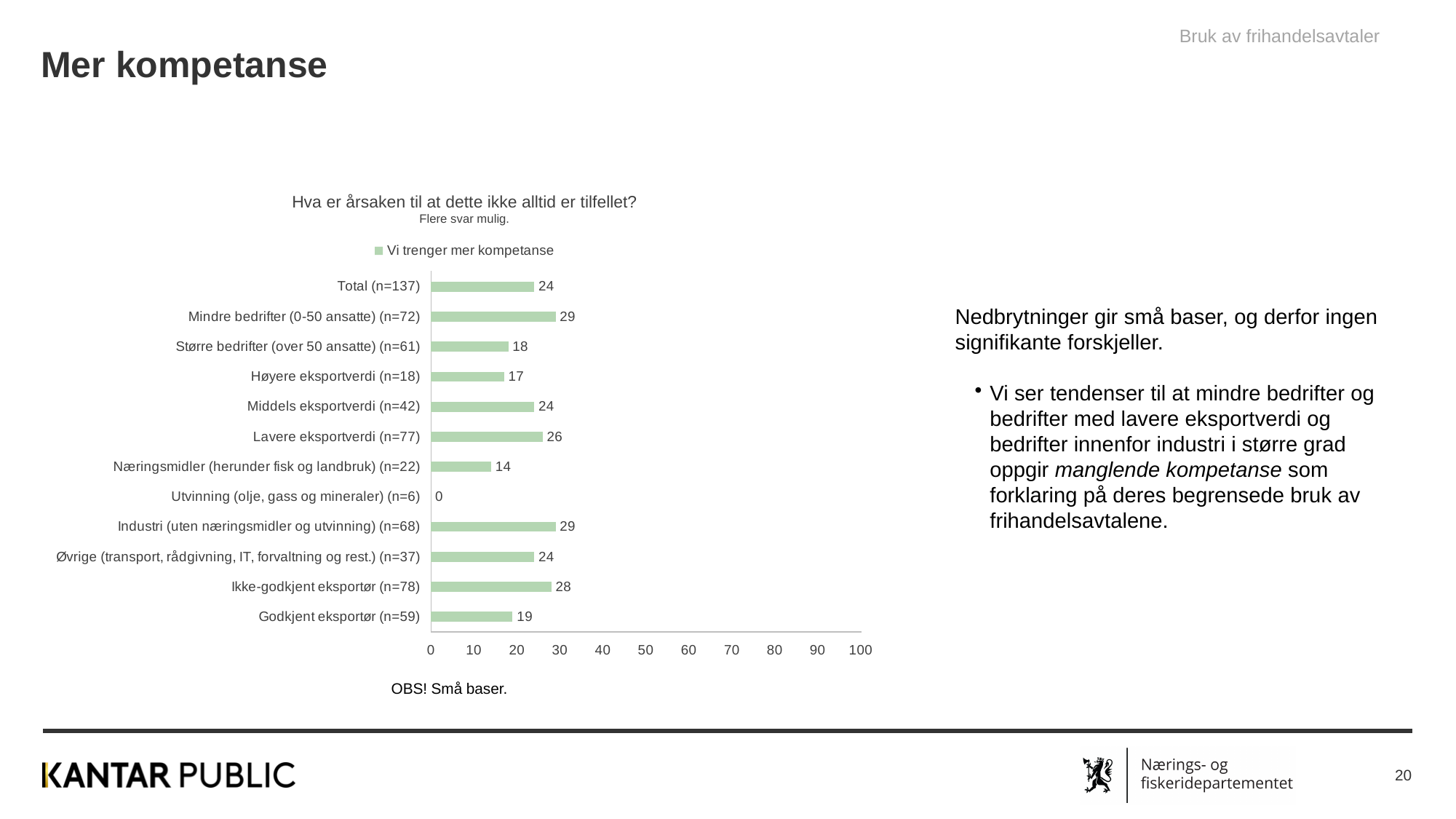
Which category has the lowest value? Utvinning (olje, gass og mineraler) (n=6) What value is shown for Total (n=137)? 24 What is the difference between the values for Mindre bedrifter (0-50 ansatte) (n=72) and Større bedrifter (over 50 ansatte) (n=61)? 11 What is the legend entry of the series shown in the chart? Vi trenger mer kompetanse Is the value for Godkjent eksportør (n=59) greater or less than 30? less What value is shown for Mindre bedrifter (0-50 ansatte) (n=72)? 29 What kind of chart is shown on the slide? bar chart What value is shown for Ikke-godkjent eksportør (n=78)? 28 How many series does the legend list? 1 Which is larger, the value for Lavere eksportverdi (n=77) or Høyere eksportverdi (n=18)? Lavere eksportverdi (n=77) How many categories are shown on the chart? 12 What value is shown for Næringsmidler (herunder fisk og landbruk) (n=22)? 14